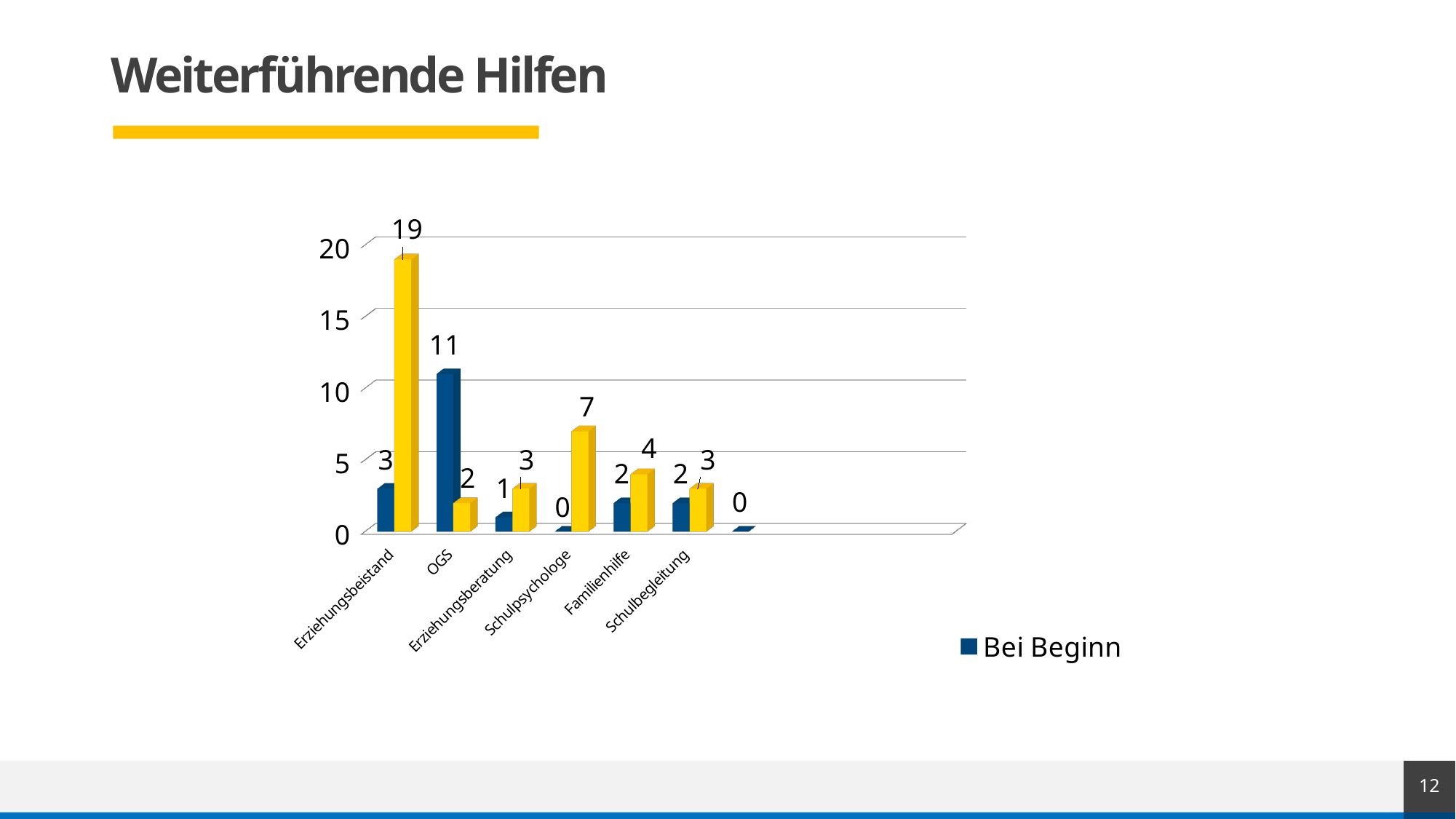
What is the difference between the Bei Beginn value and the yellow value for OGS? 9 What kind of chart is shown on the slide? bar chart Which category has the highest value in the yellow series? Erziehungsbeistand Which category has the highest Bei Beginn value? OGS What is the difference between the yellow bar and the Bei Beginn bar for Erziehungsbeistand? 16 What is the value of the yellow bar for Erziehungsbeistand? 19 Is the Bei Beginn value for OGS greater or less than 10? greater What is the value for OGS in the Bei Beginn series? 11 How many series does the legend list? 1 For Familienhilfe, which is larger: the Bei Beginn bar or the yellow bar? the yellow bar What is the value of the yellow bar for Schulpsychologe? 7 What is the Bei Beginn value for Erziehungsberatung? 1